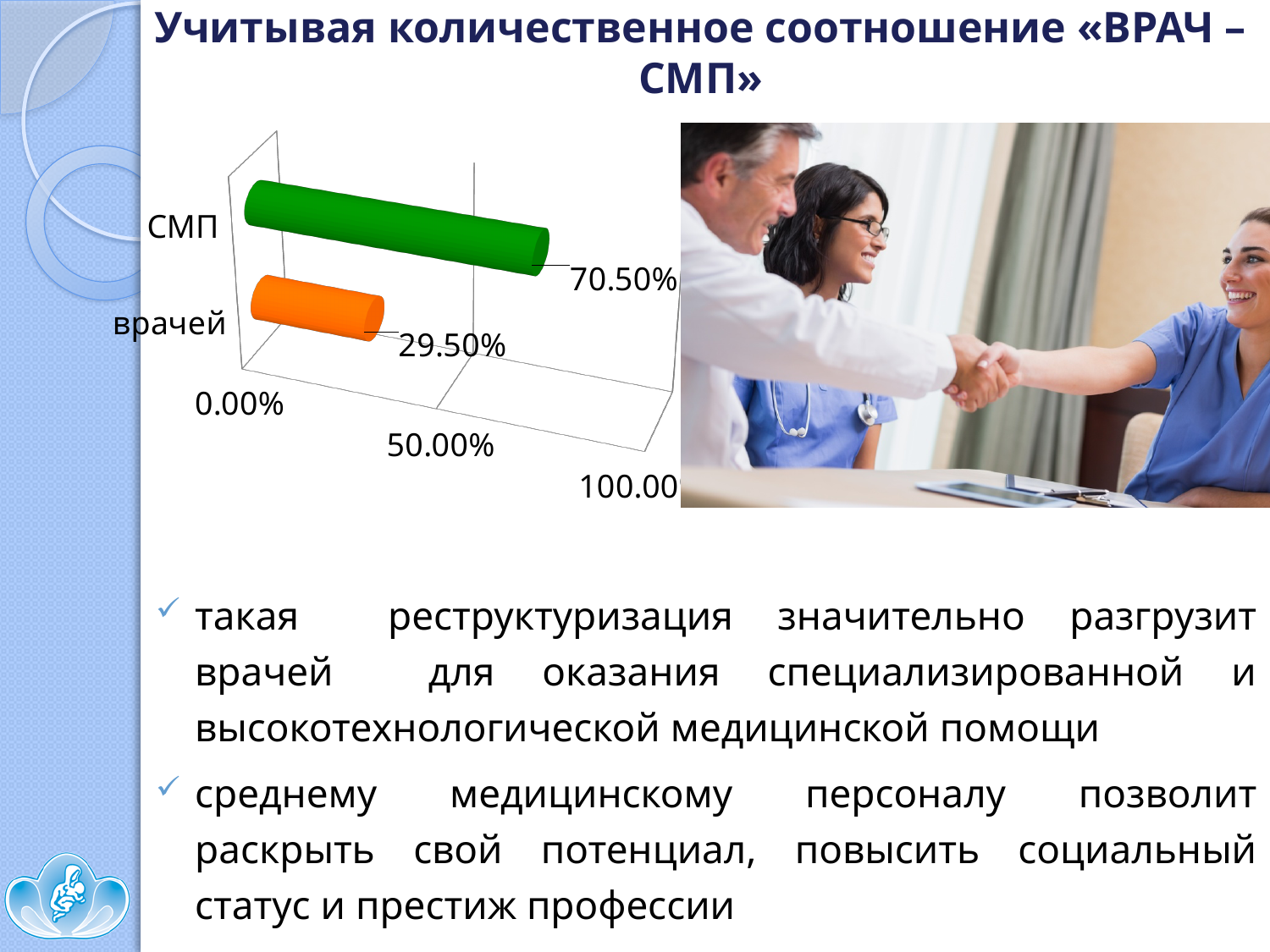
What colour is the bar for СМП? green What colour is the bar for врачей? orange Which category has the lowest value? врачей Which is larger, the value for СМП or the value for врачей? СМП What kind of chart is shown on the slide? bar chart How many categories are shown in the chart? 2 What is the difference between the values for СМП and врачей? 41.00% Is the value for СМП greater or less than 50.00%? greater Is the value for врачей greater or less than 50.00%? less What is the value shown for СМП? 70.50% Which category has the highest value? СМП What is the value shown for врачей? 29.50%